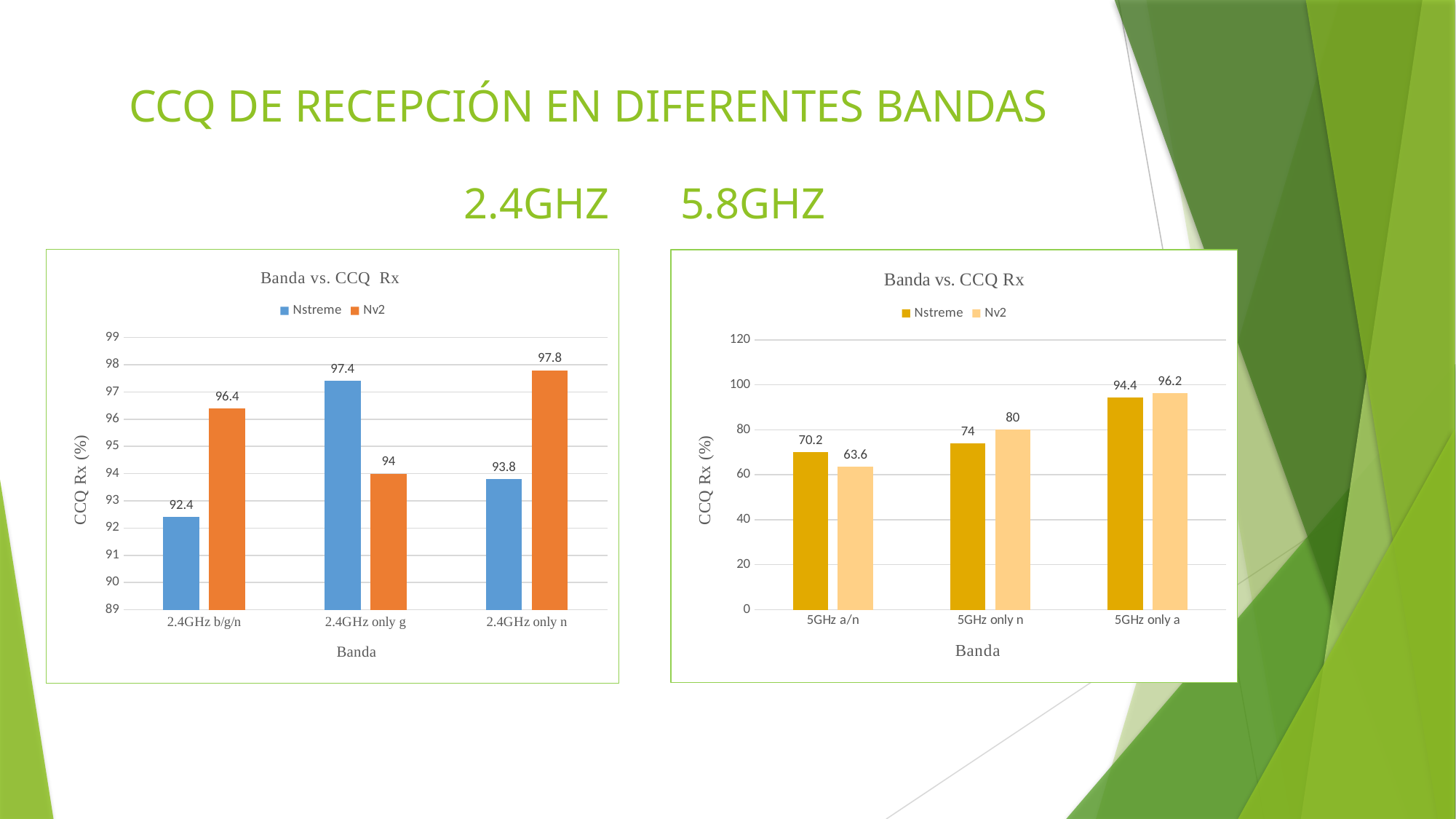
In the right chart (5.8GHz), what is the Nstreme value for 5GHz a/n? 70.2 How many series does the legend of the left chart (2.4GHz) list? 2 In the left chart (2.4GHz), which is larger for 2.4GHz only g: Nstreme or Nv2? Nstreme In the right chart (5.8GHz), which band has the lowest Nv2 value? 5GHz a/n In the left chart (2.4GHz), what is the difference between the Nv2 and Nstreme values for 2.4GHz b/g/n? 4 What kind of chart is the right chart (5.8GHz)? Bar chart In the right chart (5.8GHz), what is the Nv2 value for 5GHz only n? 80 In the left chart (2.4GHz), what is the Nstreme value for 2.4GHz b/g/n? 92.4 In the left chart (2.4GHz), what is the Nv2 value for 2.4GHz only n? 97.8 In the left chart (2.4GHz), which band has the highest Nstreme value? 2.4GHz only g How many bands are shown on the x axis of the right chart (5.8GHz)? 3 In the right chart (5.8GHz), what is the difference between the Nv2 and Nstreme values for 5GHz only n? 6